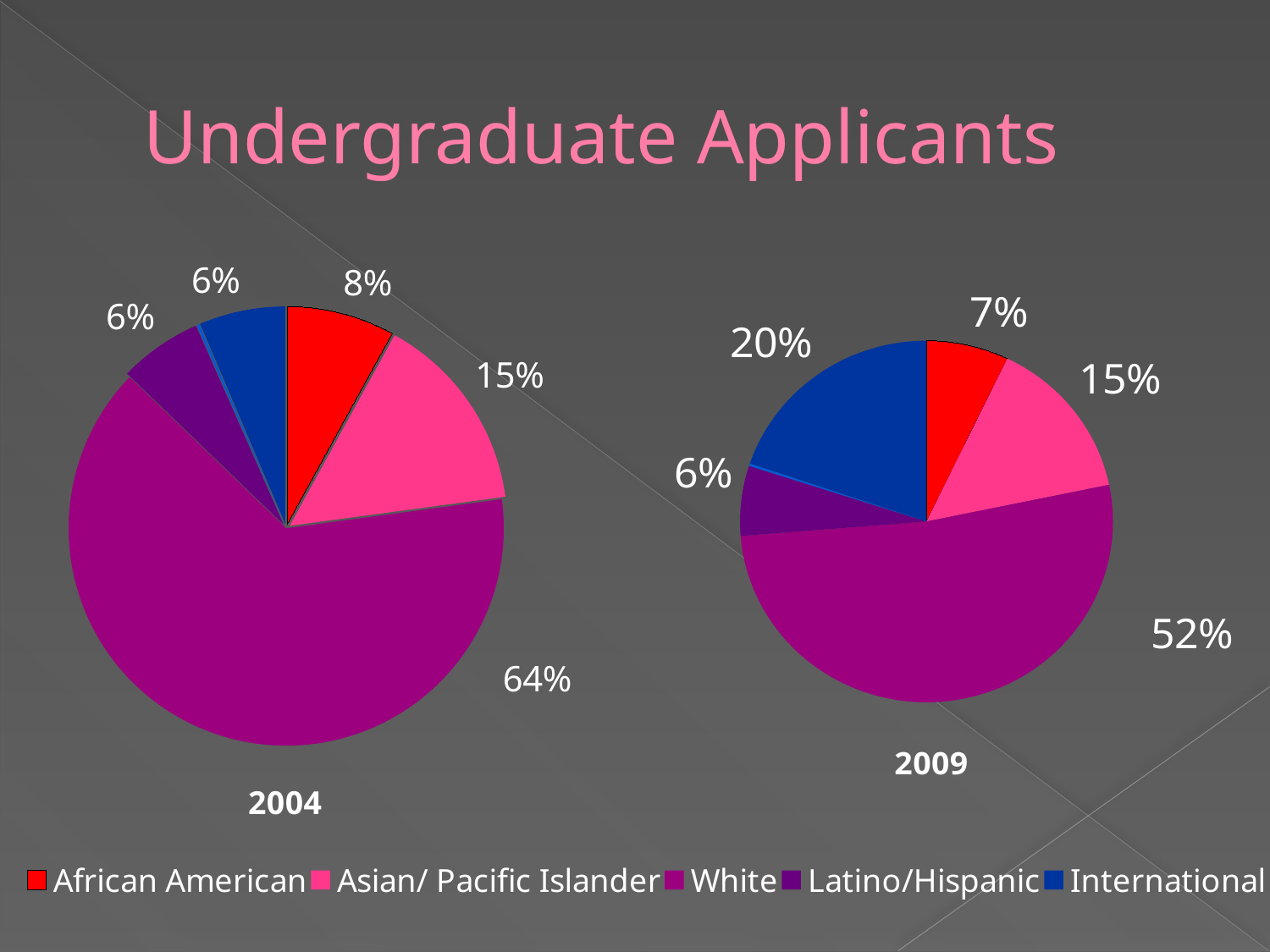
What is the difference between the White share in the 2004 pie chart and the White share in the 2009 pie chart? 12% In the 2009 pie chart, what share of undergraduate applicants were International? 20% Which is larger: the International share in the 2004 pie chart or the International share in the 2009 pie chart? 2009 In the 2009 pie chart, which category has the largest share? White In the 2009 pie chart, which category has the smallest share? Latino/Hispanic In the 2009 pie chart, what percentage of applicants were Asian/ Pacific Islander? 15% What is the title of the slide? Undergraduate Applicants What kind of charts are shown on the slide? Pie charts How many categories does the legend list? 5 In the 2004 pie chart, what percentage of applicants were African American? 8% How many pie charts are on the slide? 2 In the 2004 pie chart, what share of undergraduate applicants were White? 64%